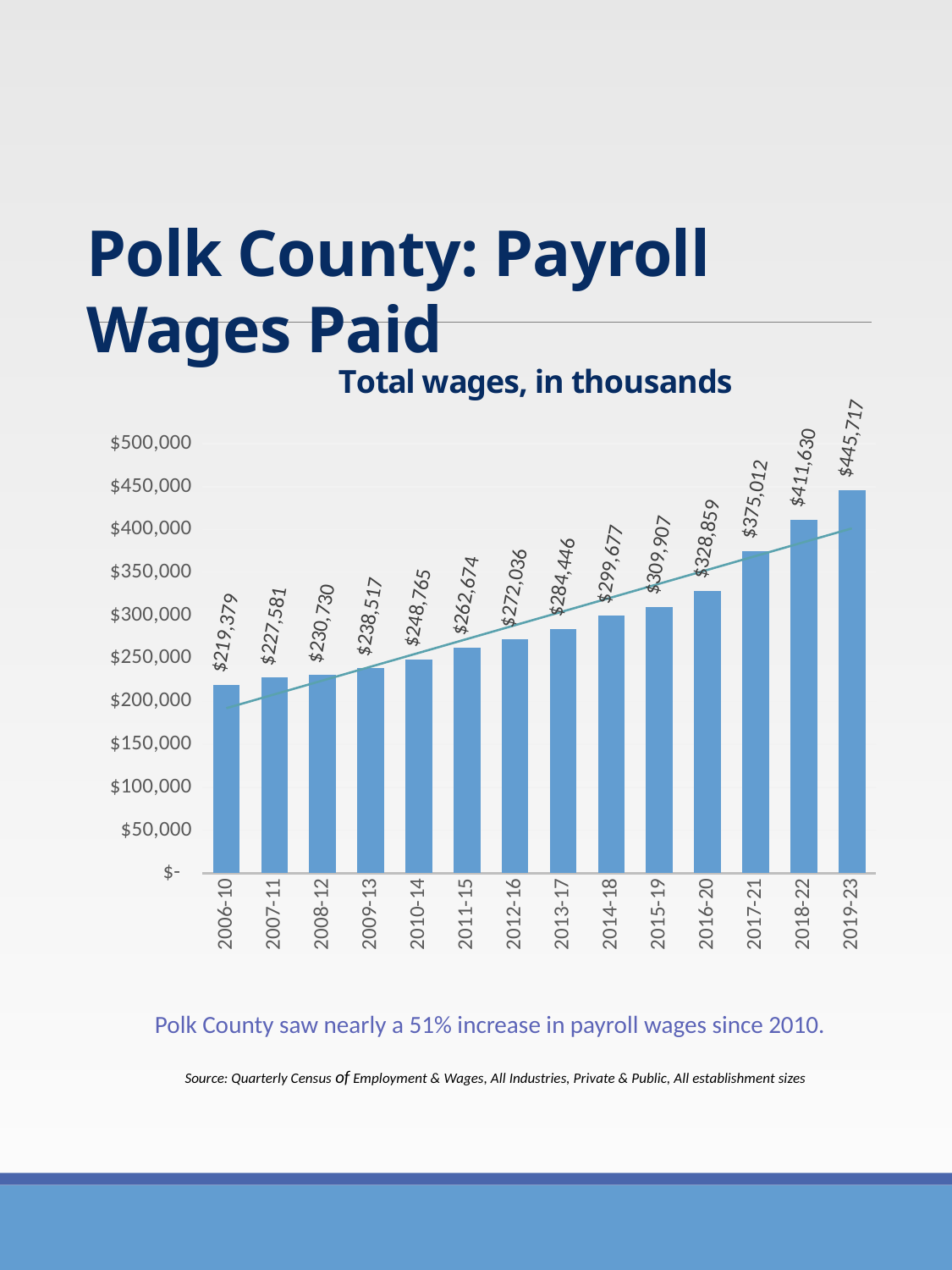
How many periods are shown on the x axis? 14 What kind of chart is this? Bar chart What is the difference between the values for 2019-23 and 2006-10? $226,338 What is the value for 2013-17? $284,446 What is the value for 2017-21? $375,012 Do the values rise or fall from 2006-10 to 2019-23? Rise Which is larger, the value for 2015-19 or the value for 2016-20? 2016-20 What is the value for 2006-10? $219,379 What is the value for 2019-23? $445,717 Which period has the lowest total wages? 2006-10 What is the difference between the values for 2018-22 and 2017-21? $36,618 Which period has the highest total wages? 2019-23